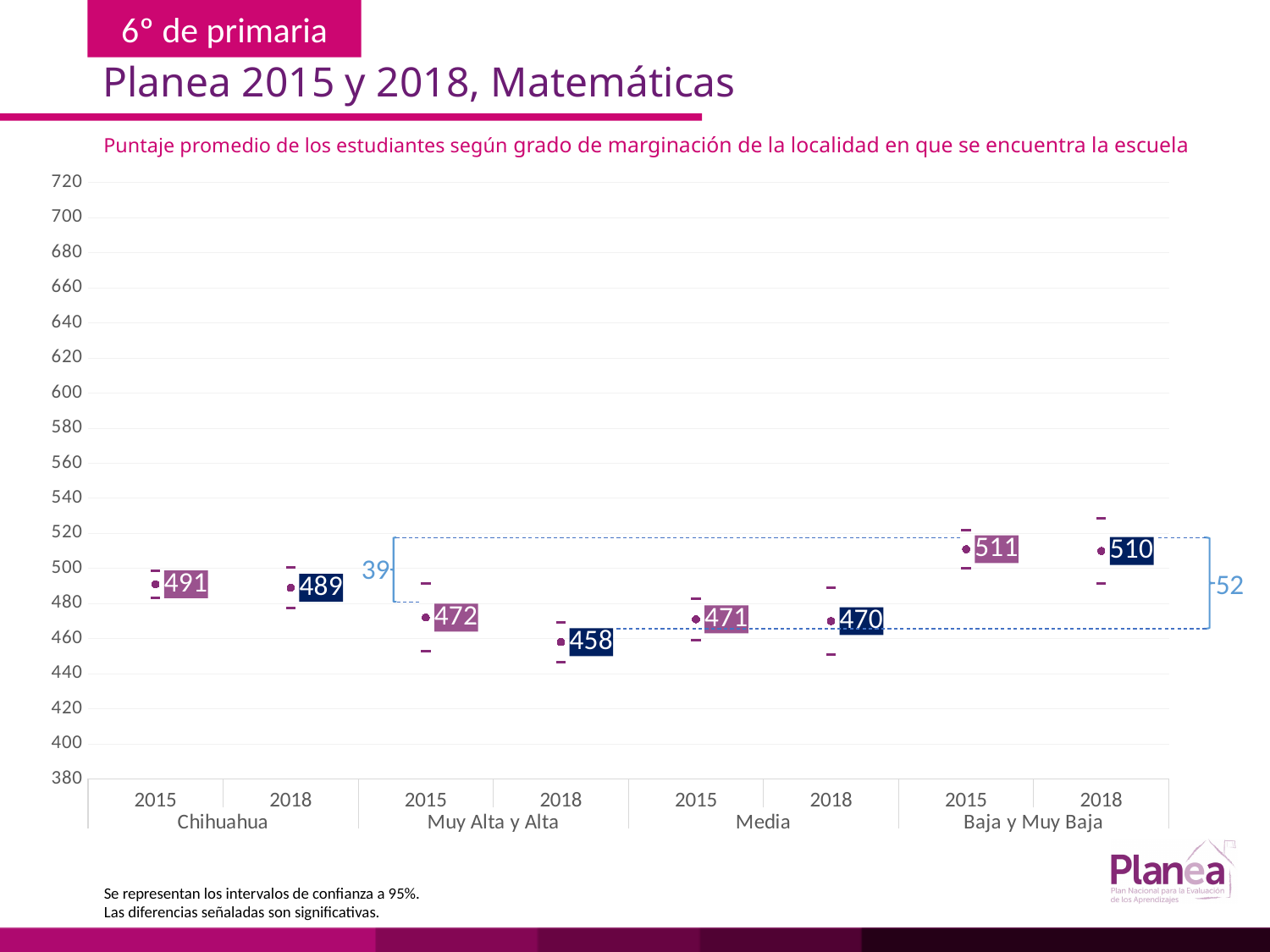
What is the average score for Baja y Muy Baja in 2015? 511 What is the average score for Muy Alta y Alta in 2018? 458 What is the average score for Chihuahua in 2015? 491 Is the 2018 score for Baja y Muy Baja greater or less than 500? greater What is the subtitle of the chart? Puntaje promedio de los estudiantes según grado de marginación de la localidad en que se encuentra la escuela Which is larger, the 2015 score for Chihuahua or the 2015 score for Muy Alta y Alta? Chihuahua 2015 (491) What is the difference between the 2015 and 2018 scores for Muy Alta y Alta? 14 Which group and year has the highest average score? Baja y Muy Baja, 2015 (511) How many marginalization groups are shown on the x axis? 4 What is the average score for Media in 2018? 470 Which group and year has the lowest average score? Muy Alta y Alta, 2018 (458) What is the difference between the Baja y Muy Baja and Muy Alta y Alta scores in 2018? 52